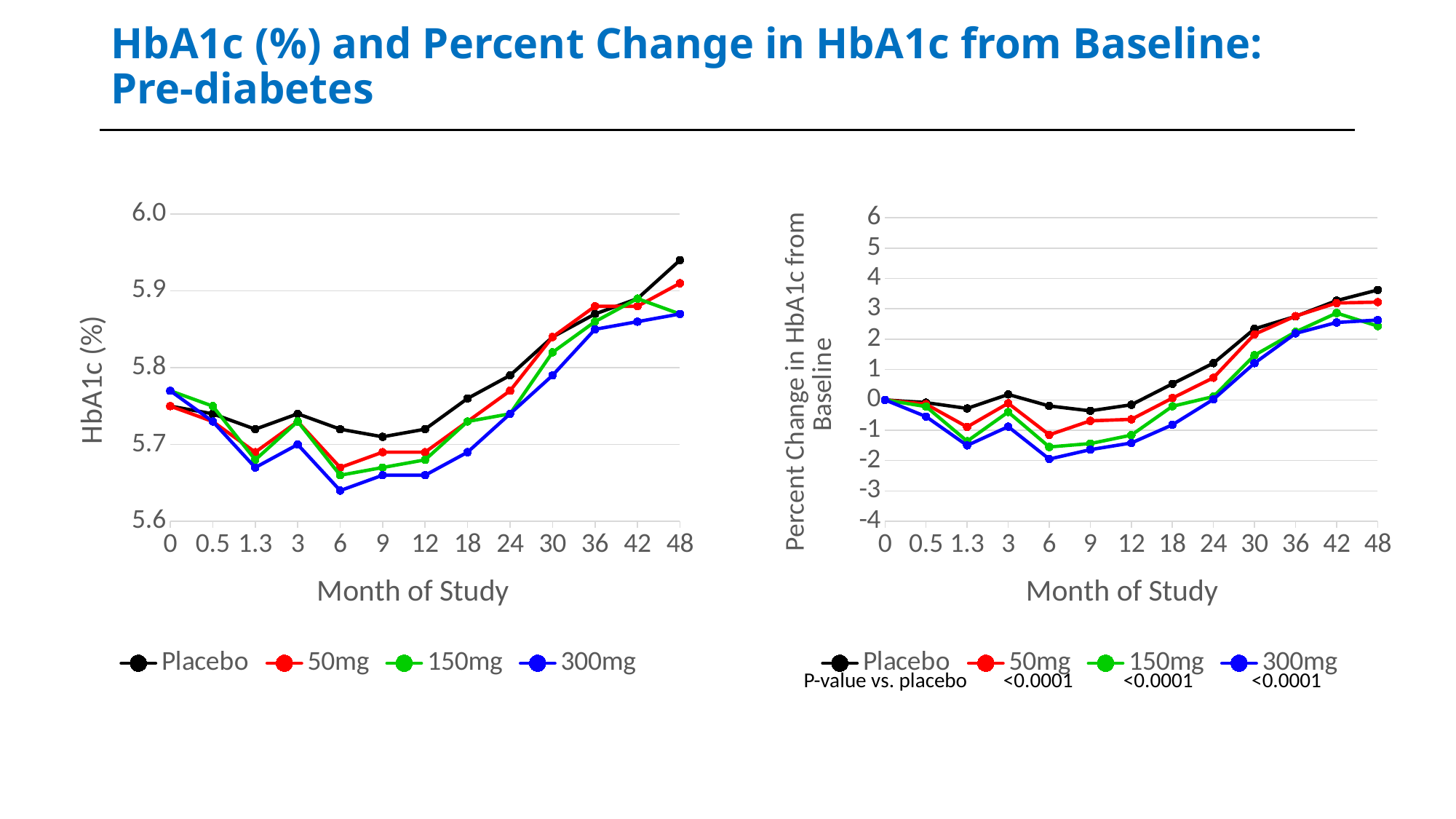
How many months of study are marked on the x axis of the left chart (HbA1c (%))? 13 In the right chart (Percent Change in HbA1c from Baseline), is the value for Placebo at month 48 greater or less than 3? greater In the left chart (HbA1c (%)), is the value for 300mg at month 6 greater or less than 5.7? less In the left chart (HbA1c (%)), which series has the highest value at month 48? Placebo In the left chart (HbA1c (%)), do the Placebo values rise or fall from month 12 to month 48? rise In the left chart (HbA1c (%)), is the value for Placebo at month 48 greater or less than 5.9? greater In the right chart (Percent Change in HbA1c from Baseline), which is larger at month 6: Placebo or 300mg? Placebo How many series does the legend of the right chart (Percent Change in HbA1c from Baseline) list? 4 In the left chart (HbA1c (%)), which series has the lowest value at month 6? 300mg In the right chart (Percent Change in HbA1c from Baseline), what is the value for Placebo at month 0? 0 What kind of chart is the left chart (HbA1c (%))? line chart